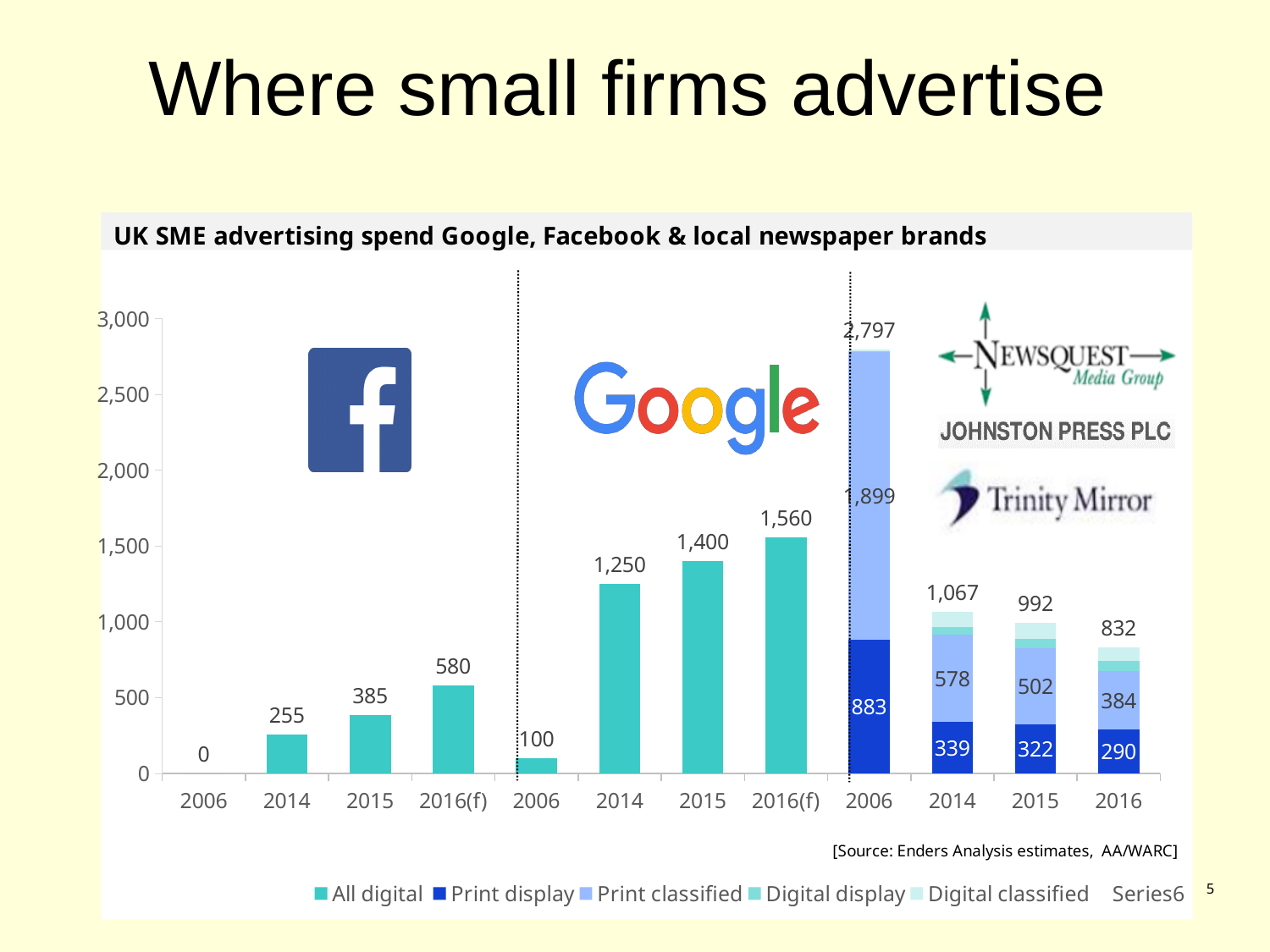
Which is larger: the Facebook value for 2016(f) or the Google value for 2006? Facebook 2016(f) Do the Facebook values rise or fall from 2006 to 2016(f)? rise How many series does the legend list? 6 What is the Facebook value for 2015? 385 What is the Print display value for local newspaper brands in 2006? 883 Do the local newspaper brand totals rise or fall from 2006 to 2016? fall What is the Google value for 2016(f)? 1,560 What kind of chart is shown on the slide? bar chart Which year has the highest Google value? 2016(f) What is the total of the stacked local newspaper bar for 2014? 1,067 What is the Print classified value for local newspaper brands in 2015? 502 What is the difference between the Google values for 2015 and 2014? 150